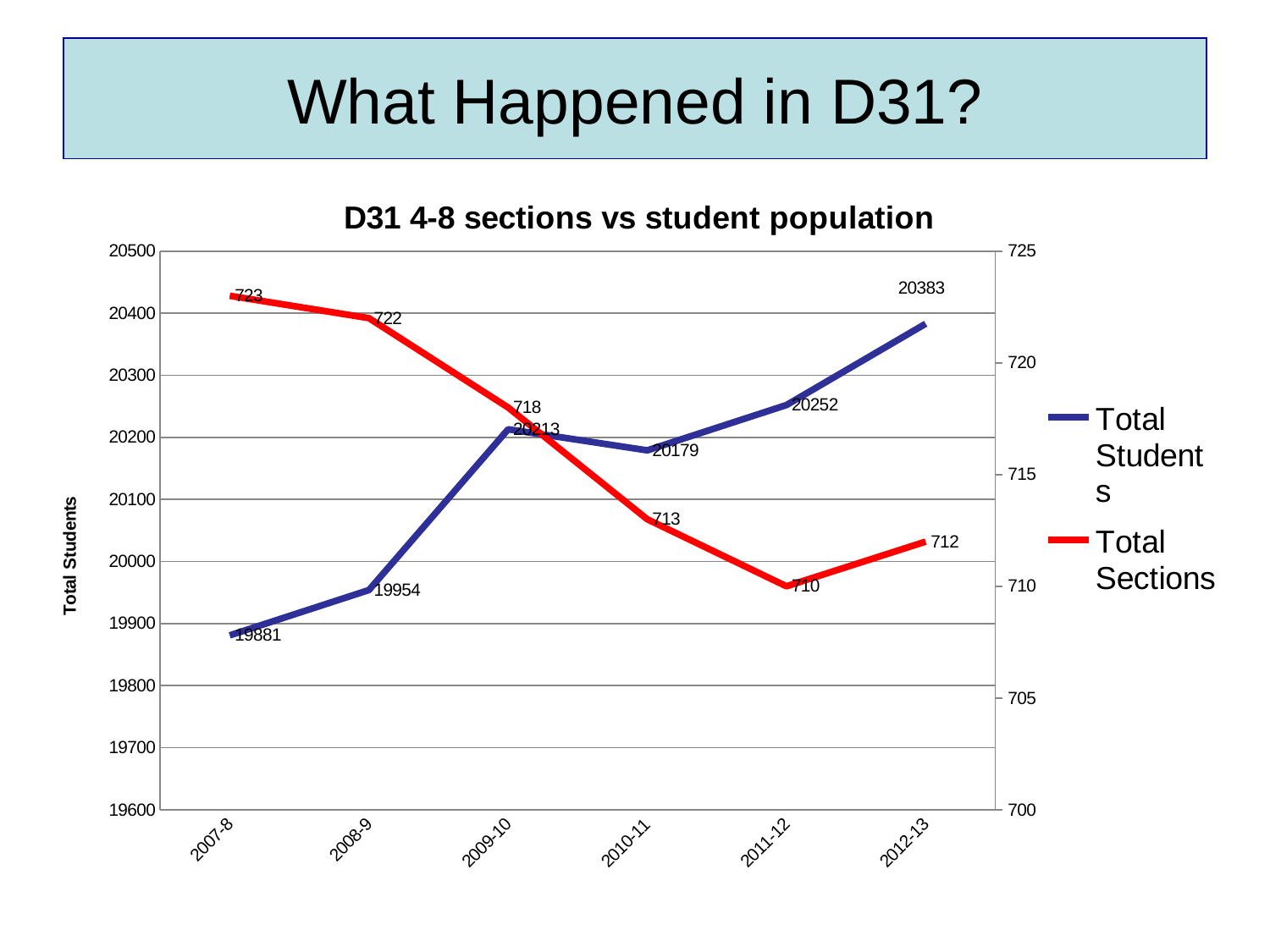
Does Total Sections generally rise or fall from 2007-8 to 2011-12? fall What is the chart's title? D31 4-8 sections vs student population What is the value of Total Sections in 2010-11? 713 In which school year is Total Students highest? 2012-13 How many series does the legend list? 2 How many school years are plotted along the x axis? 6 What is the difference between Total Students in 2012-13 and in 2007-8? 502 Which is larger, Total Students in 2009-10 or in 2010-11? 2009-10 What is the value of Total Students in 2012-13? 20383 In which school year is Total Sections lowest? 2011-12 What kind of chart is shown on the slide? line chart What is the difference between Total Sections in 2007-8 and in 2011-12? 13